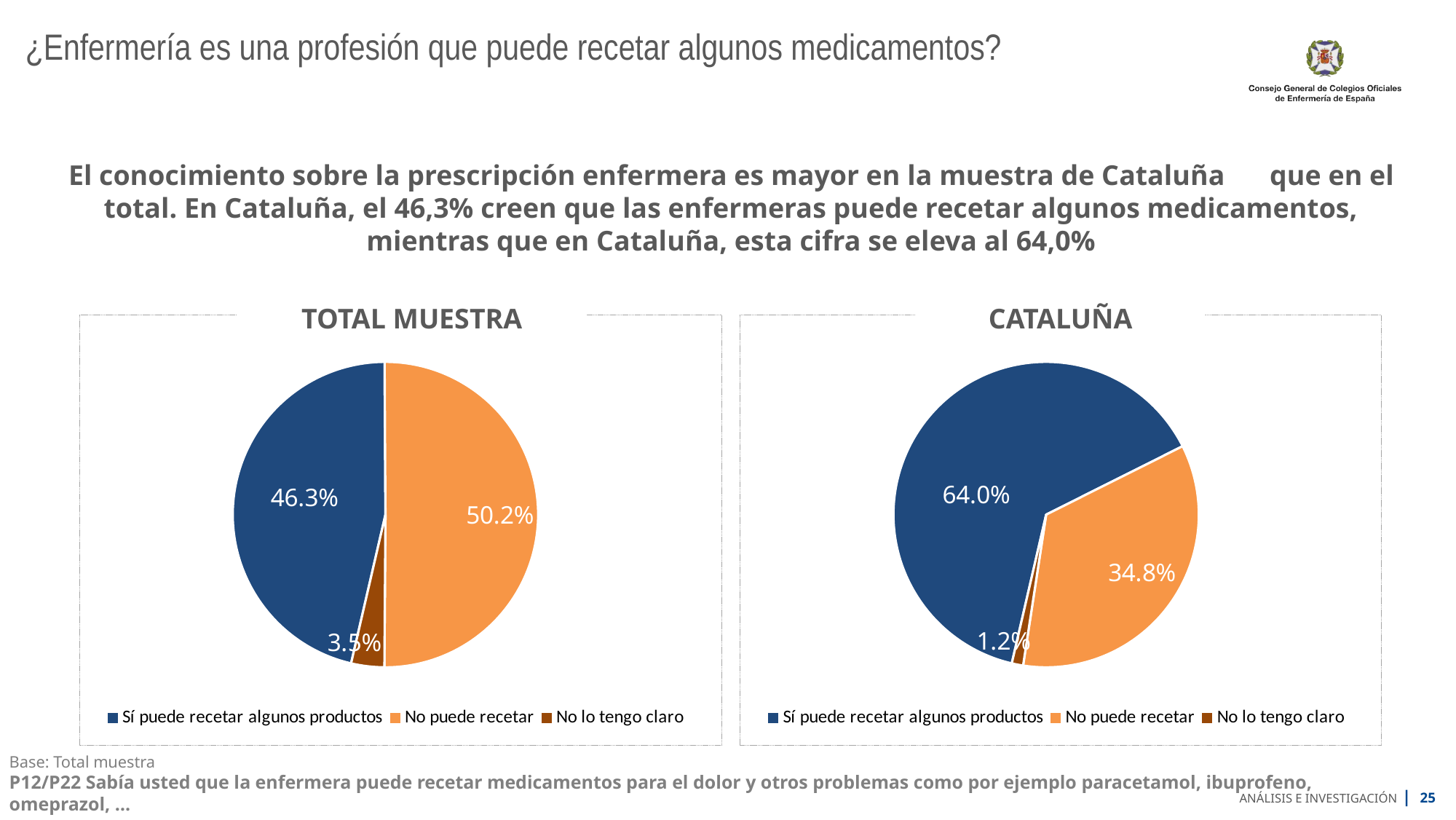
What is the difference between the "Sí puede recetar algunos productos" value in the CATALUÑA chart and in the TOTAL MUESTRA chart? 17.7% In the TOTAL MUESTRA chart, what is the value for "No puede recetar"? 50.2% In the TOTAL MUESTRA chart, which category has the largest slice? No puede recetar How many categories does the legend of the CATALUÑA chart list? 3 In the CATALUÑA chart, what is the value for "No puede recetar"? 34.8% In the CATALUÑA chart, what is the difference between "Sí puede recetar algunos productos" and "No puede recetar"? 29.2% Which is larger: "No lo tengo claro" in the TOTAL MUESTRA chart or in the CATALUÑA chart? TOTAL MUESTRA In the TOTAL MUESTRA chart, which category has the smallest slice? No lo tengo claro In the TOTAL MUESTRA chart, what is the value for "Sí puede recetar algunos productos"? 46.3% In the CATALUÑA chart, what is the value for "No lo tengo claro"? 1.2% In the CATALUÑA chart, which category has the largest slice? Sí puede recetar algunos productos What type of chart is used on this slide? Pie chart